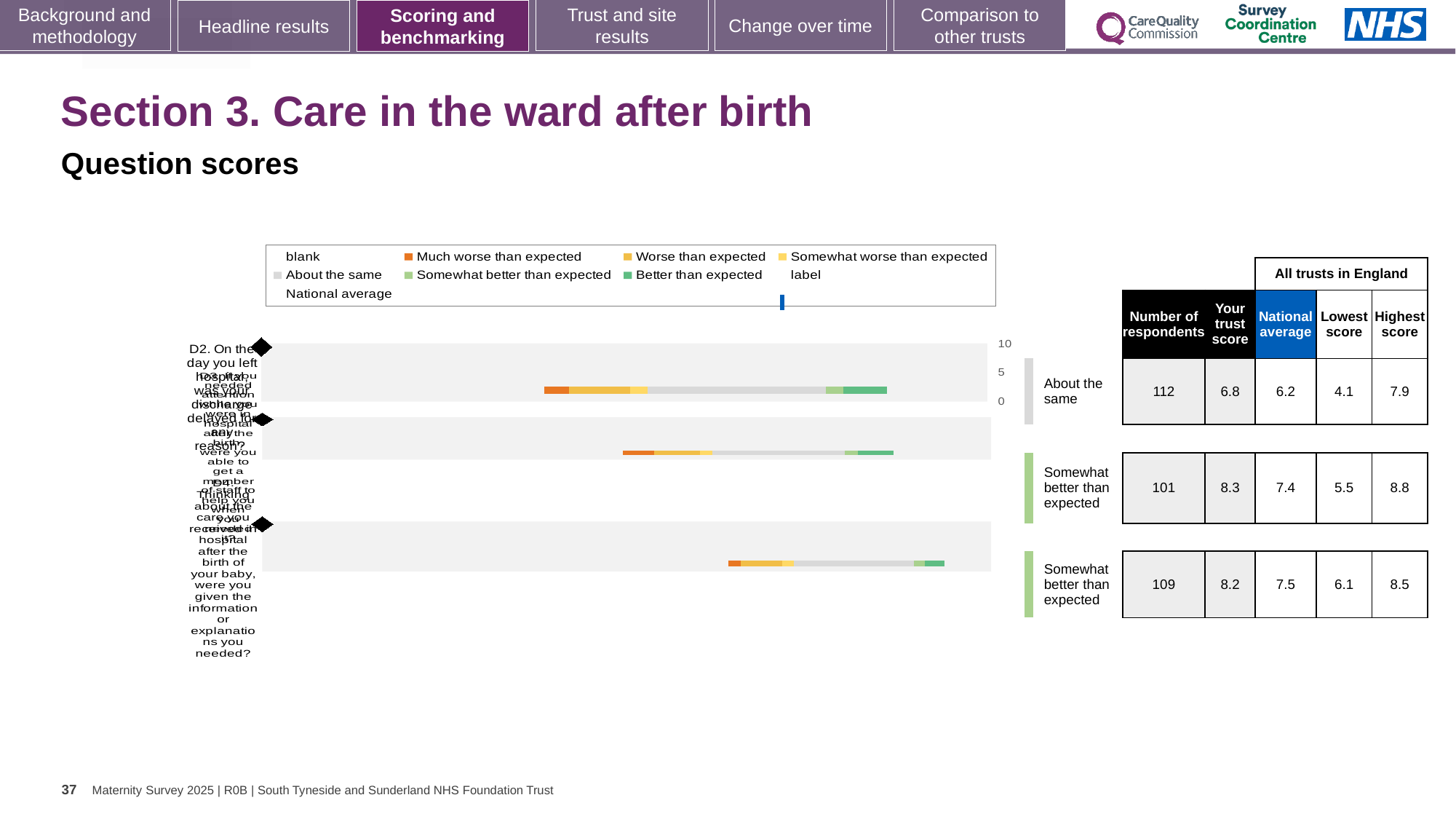
In the table beside the chart, what is the national average for the second bar? 7.4 What kind of chart is shown on the slide? bar chart In the table beside the chart, what is the highest score in England for the second bar? 8.8 In the table beside the chart, what is the number of respondents for the first (top) bar, labelled 'About the same'? 112 For the top bar, which is larger: 'Your trust score' or the national average? Your trust score In the chart legend, which colour represents 'Much worse than expected'? orange Which of the three bars has the highest 'Your trust score' in the table? the second bar (8.3) How many bars (questions) are plotted in the chart? 3 What is the highest tick value shown on the chart's score axis? 10 In the table beside the chart, what is 'Your trust score' for the top bar, labelled 'About the same'? 6.8 In the table beside the chart, what is the lowest score in England for the third (bottom) bar? 6.1 For the second bar, what is the difference between 'Your trust score' (8.3) and the national average (7.4)? 0.9